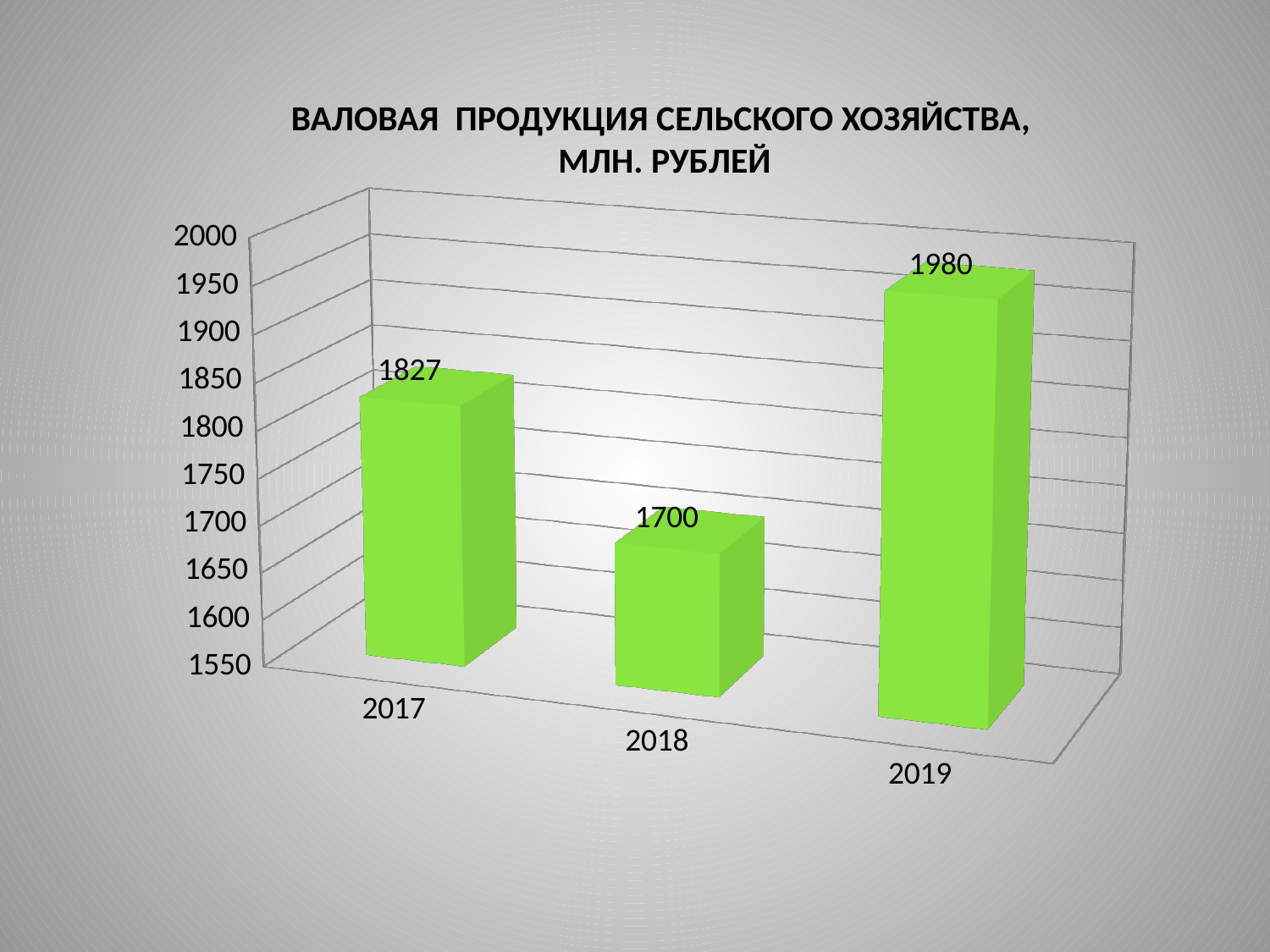
Which year has the highest value? 2019 What kind of chart is shown on the slide? bar chart What is the difference between the values for 2019 and 2018? 280 What is the value for 2019? 1980 Which year has the lowest value? 2018 Is the value for 2018 greater or less than 1750? less What is the value for 2018? 1700 What is the difference between the values for 2017 and 2018? 127 Which is larger, the value for 2017 or the value for 2019? 2019 How many years are shown on the chart? 3 What is the value for 2017? 1827 What is the title of the chart? ВАЛОВАЯ ПРОДУКЦИЯ СЕЛЬСКОГО ХОЗЯЙСТВА, МЛН. РУБЛЕЙ